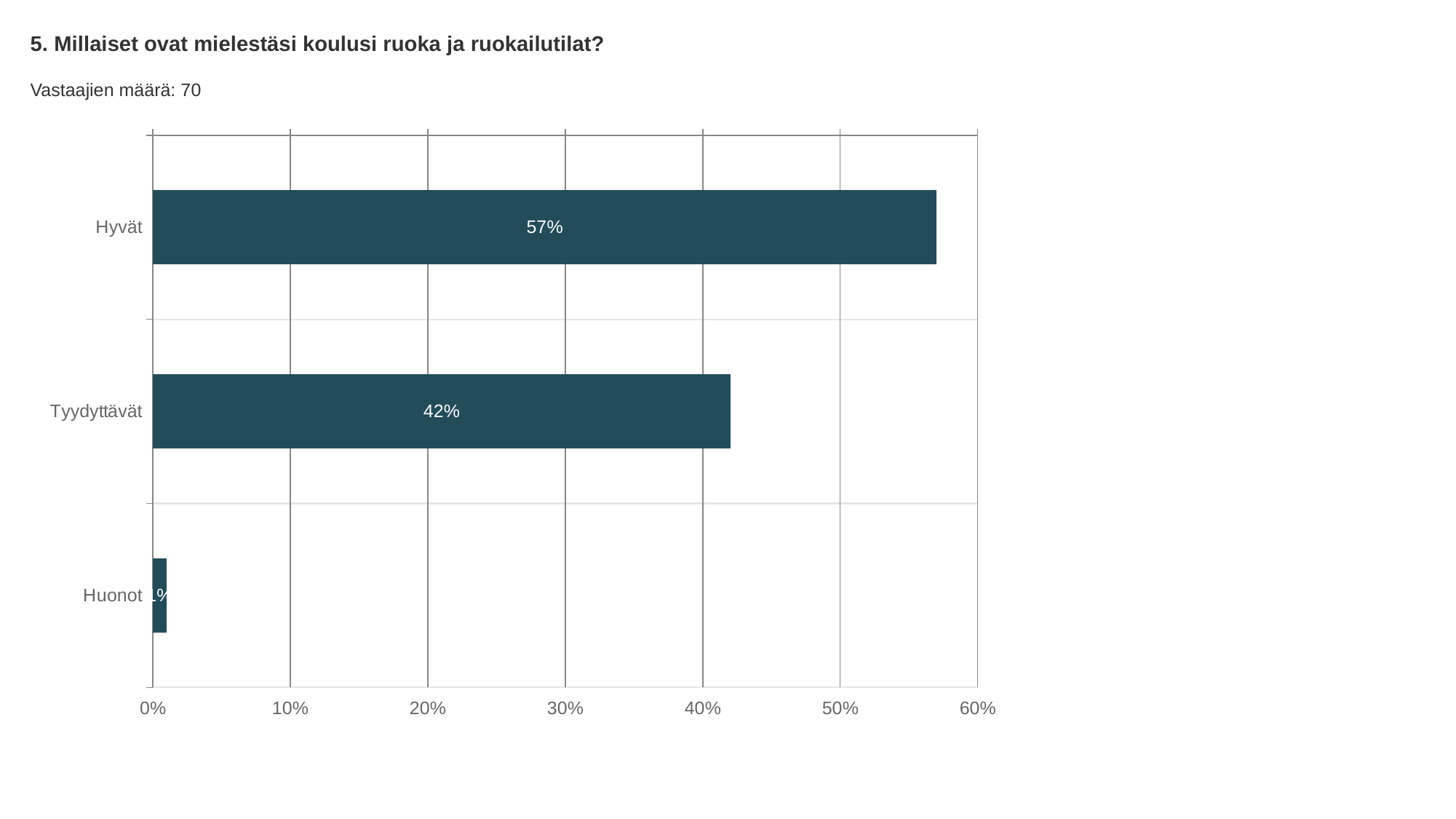
Which category has the highest value? Hyvät Is the value for Hyvät greater or less than 50%? greater Which is larger, the value for Tyydyttävät or the value for Huonot? Tyydyttävät What is the value for Huonot? 1% How many categories are shown in the chart? 3 Which category has the lowest value? Huonot What is the difference between the values for Hyvät and Tyydyttävät? 15% Is the value for Tyydyttävät greater or less than 40%? greater How many respondents (Vastaajien määrä) are reported on the slide? 70 What is the value for Tyydyttävät? 42% What is the value for Hyvät? 57% What kind of chart is shown on the slide? bar chart